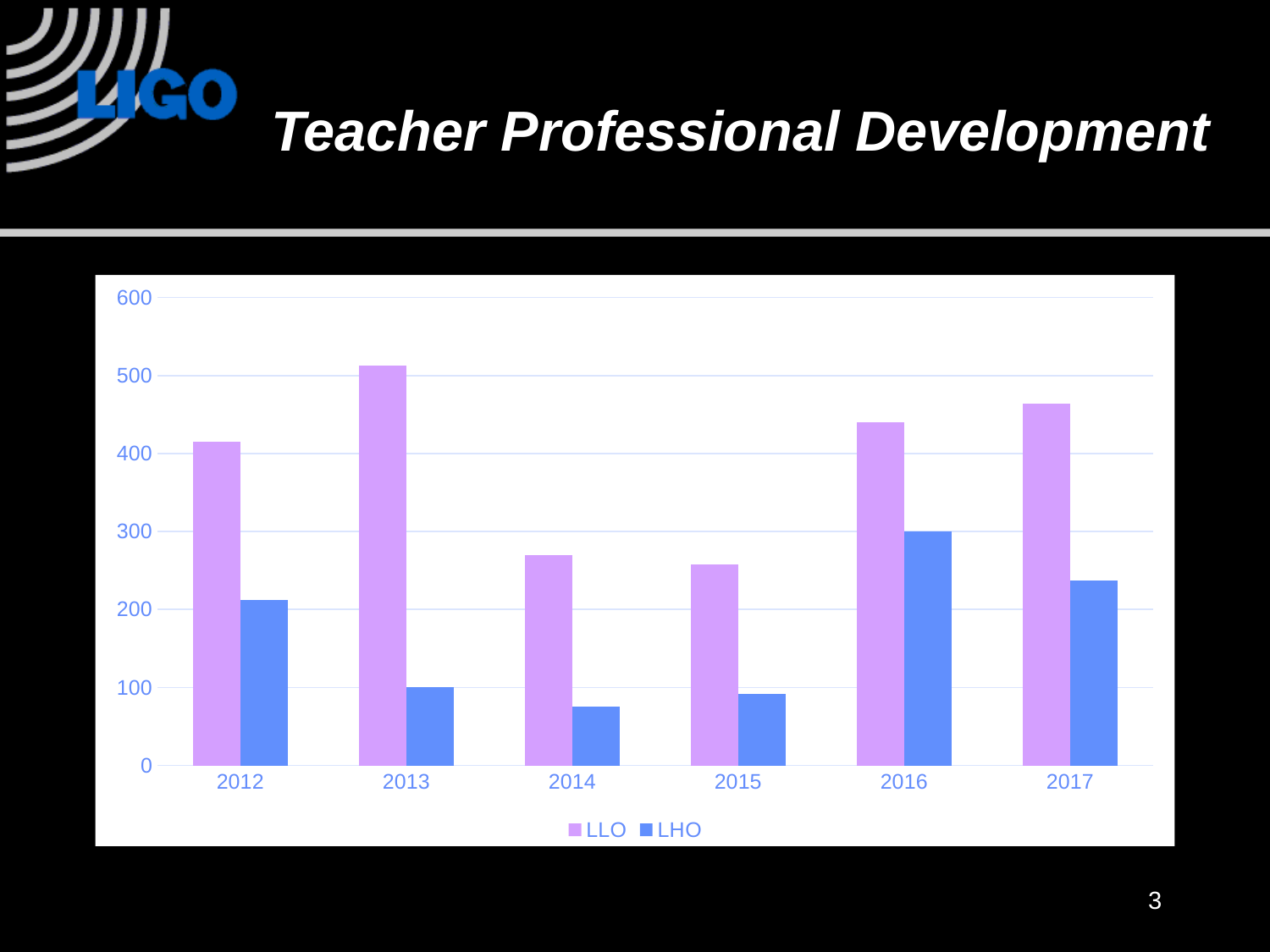
Which is larger for LHO, the 2012 value or the 2013 value? 2012 Is the LLO value for 2017 greater or less than 400? greater How many series does the legend list? 2 Is the LLO value for 2015 greater or less than 300? less In which year is the LHO value highest? 2016 What kind of chart is shown on the slide? bar chart Does the LHO value rise or fall from 2014 to 2016? rise Is the LLO value for 2013 greater or less than 500? greater In which year is the LLO value highest? 2013 How many years are shown on the x axis? 6 Which is larger in 2016, the LLO value or the LHO value? LLO